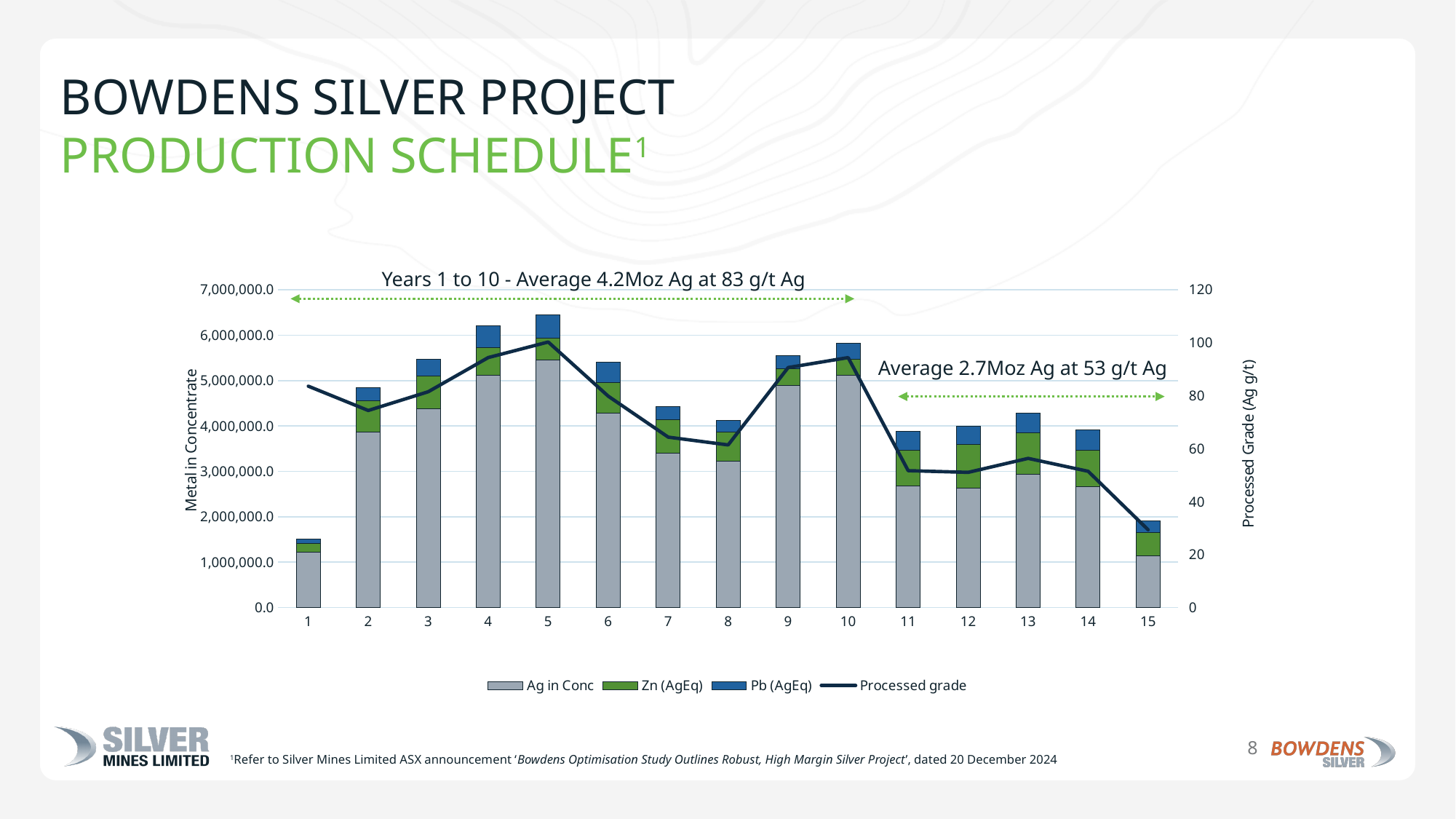
Is the Processed grade for year 15 greater or less than 40? less Which year has the larger total metal in concentrate, year 2 or year 4? 4 How many years (categories) are shown on the x axis of the chart? 15 What kind of chart is shown on the slide? Stacked bar chart with a line series Which year has the shortest stacked bar for metal in concentrate? 1 Is the total metal in concentrate for year 5 greater or less than 6,000,000.0? greater Which year has the tallest stacked bar for metal in concentrate? 5 Is the total metal in concentrate for year 1 greater or less than 2,000,000.0? less In which year does the Processed grade line reach its highest point? 5 How many series does the chart legend list? 4 In which year does the Processed grade line reach its lowest point? 15 According to the annotation on the chart, what is the average production for years 1 to 10? 4.2Moz Ag at 83 g/t Ag